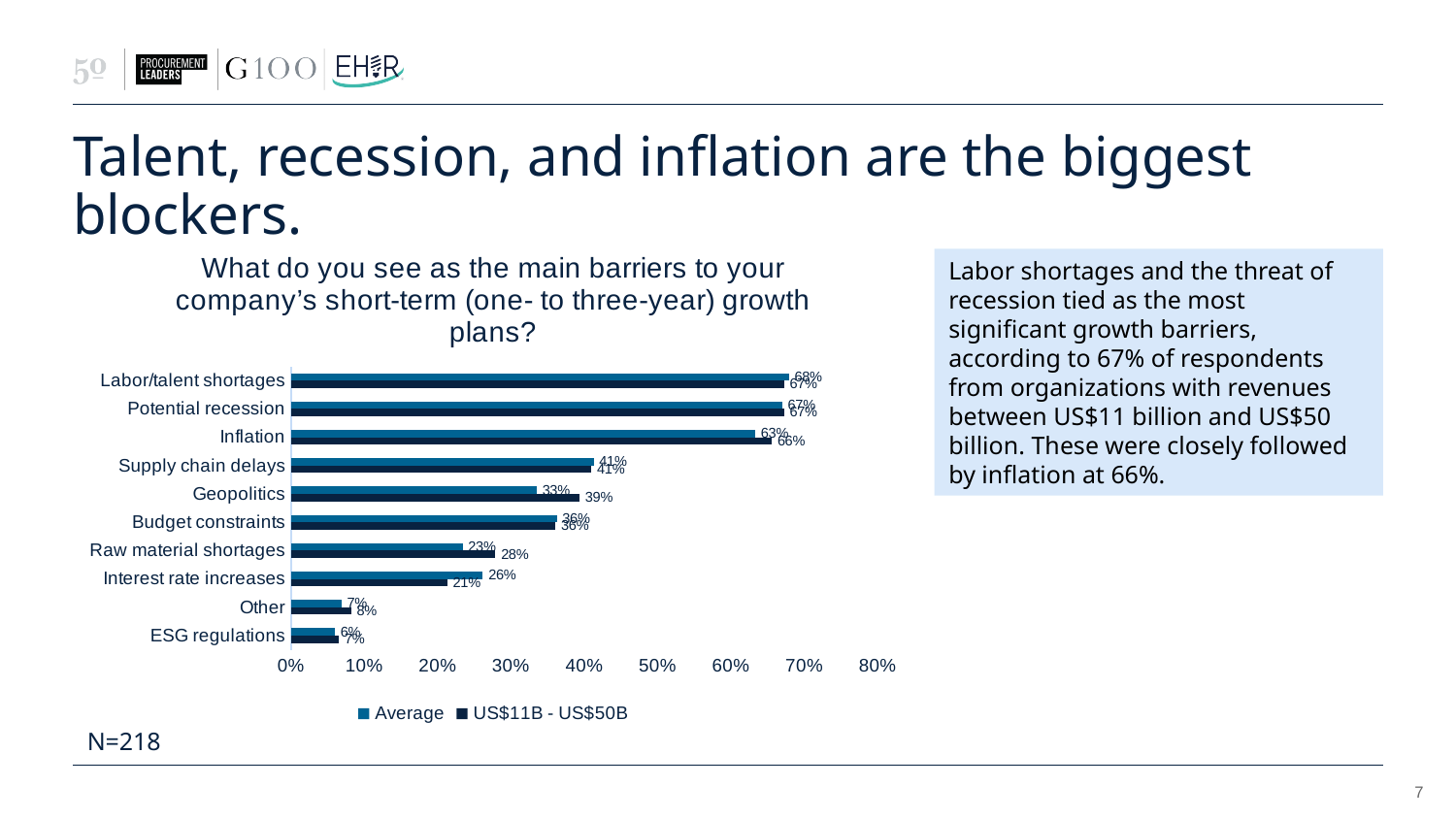
What is the Average value for Inflation? 63% For Interest rate increases, which series has the larger value, Average or US$11B - US$50B? Average For Geopolitics, what is the difference between the US$11B - US$50B value and the Average value? 6 percentage points What kind of chart is shown on the slide? bar chart What is the US$11B - US$50B value for Inflation? 66% Is the Average value for Budget constraints greater or less than 30%? greater What is the US$11B - US$50B value for Geopolitics? 39% What is the Average value for Raw material shortages? 23% How many barrier categories are plotted on the chart? 10 What is the US$11B - US$50B value for Interest rate increases? 21% What are the two series named in the chart legend? Average and US$11B - US$50B How many series does the chart legend list? 2